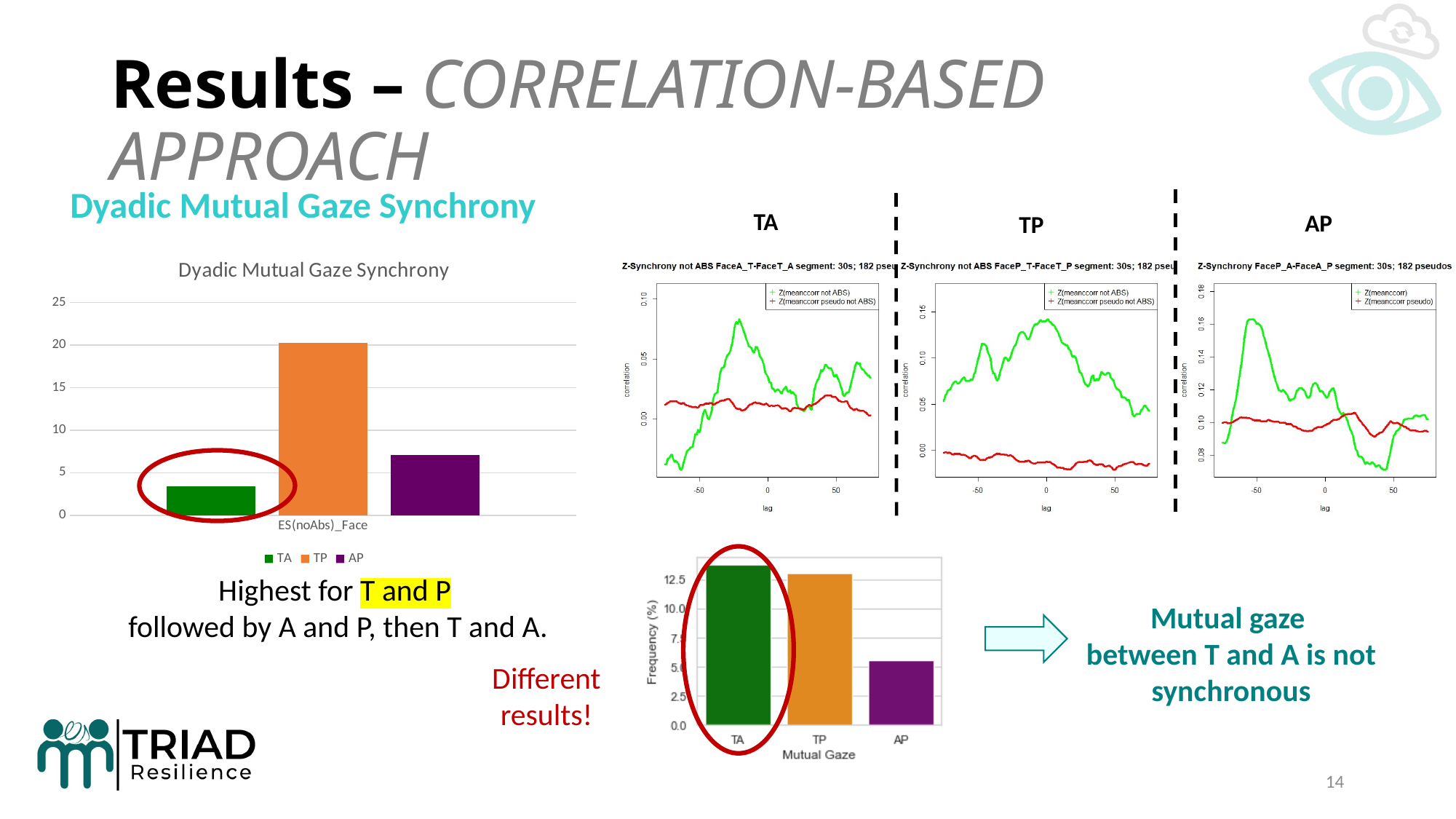
In the 'Dyadic Mutual Gaze Synchrony' bar chart, which series has the lowest value? TA In the 'Dyadic Mutual Gaze Synchrony' bar chart, what is the category label shown on the x axis? ES(noAbs)_Face In the bottom 'Mutual Gaze' frequency bar chart, which category has the lowest value? AP In the 'Dyadic Mutual Gaze Synchrony' bar chart, is the value for TA greater or less than 5? less In the bottom 'Mutual Gaze' frequency bar chart, how many categories are shown on the x axis? 3 In the 'Dyadic Mutual Gaze Synchrony' bar chart, which is larger, AP or TA? AP In the 'Dyadic Mutual Gaze Synchrony' bar chart, is the value for TP greater or less than 15? greater In the 'Dyadic Mutual Gaze Synchrony' bar chart, how many series does the legend list? 3 In the bottom 'Mutual Gaze' frequency bar chart, is the value for AP greater or less than 7.5? less What kind of chart is the 'Dyadic Mutual Gaze Synchrony' chart on the left of the slide? bar chart How many line charts of Z-Synchrony are shown on the right side of the slide? 3 In the 'Dyadic Mutual Gaze Synchrony' bar chart, which series has the highest value? TP